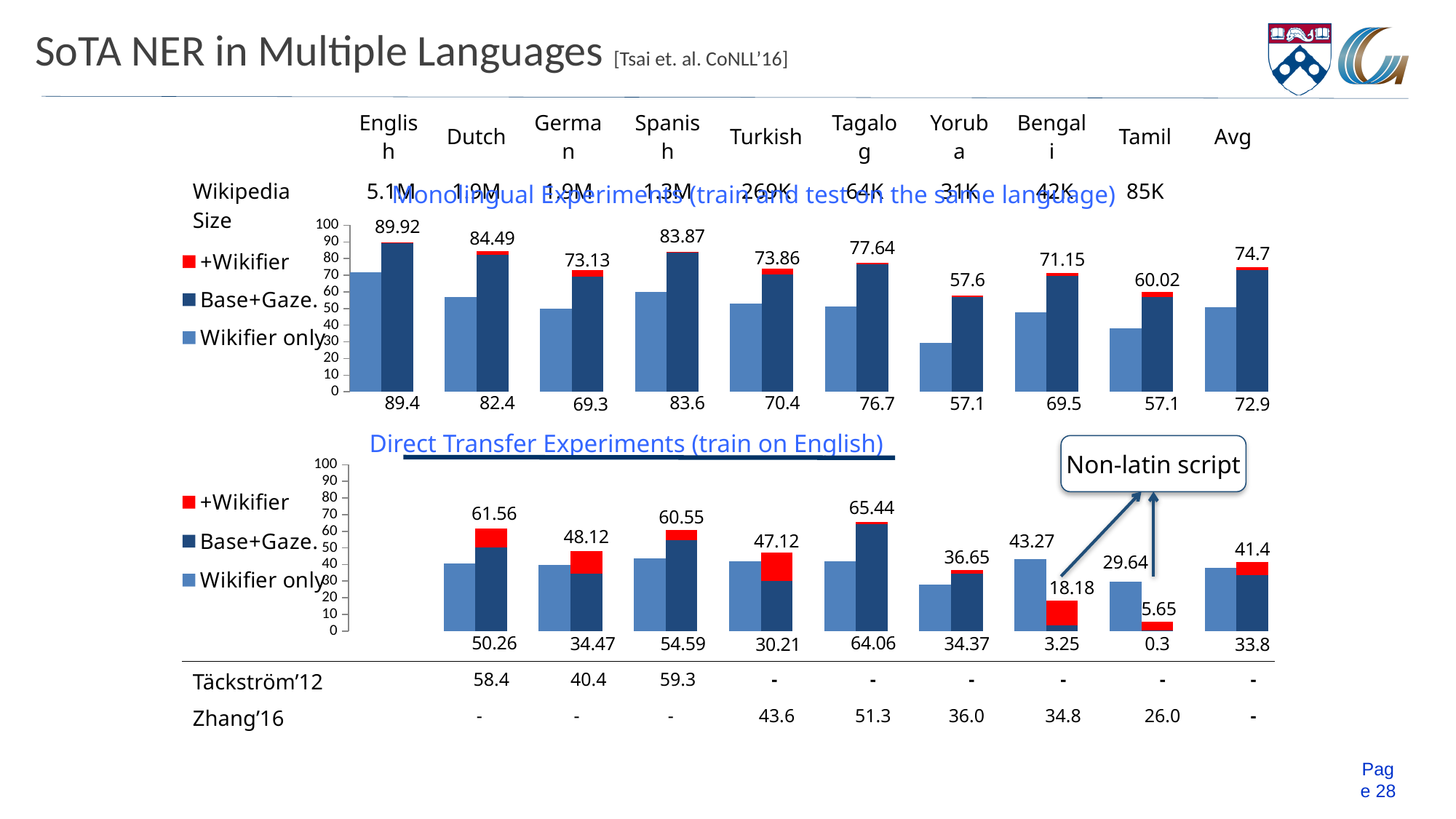
In the Monolingual Experiments chart, what total is labeled above the stacked bar for English? 89.92 In the Direct Transfer Experiments chart, what is the difference between the total labeled above the Dutch stacked bar (61.56) and the value labeled below it (50.26)? 11.3 In the Direct Transfer Experiments chart, which has the larger total labeled above its stacked bar, Spanish or German? Spanish In the Direct Transfer Experiments chart, what value is labeled on the Wikifier only bar for Bengali? 43.27 What kind of chart is the Monolingual Experiments chart? bar chart In the Monolingual Experiments chart, which language has the lowest total labeled above its stacked bar? Yoruba In the Monolingual Experiments chart, is the Wikifier only value for Yoruba greater or less than 40? less How many series does the legend of the Direct Transfer Experiments chart list? 3 In the Direct Transfer Experiments chart, what total is labeled above the stacked bar for Tagalog? 65.44 In the Monolingual Experiments chart, what value is labeled below the bar for Tagalog? 76.7 In the Direct Transfer Experiments chart, what value is labeled below the bar for Tamil? 0.3 In the Monolingual Experiments chart, which language has the highest total labeled above its stacked bar? English